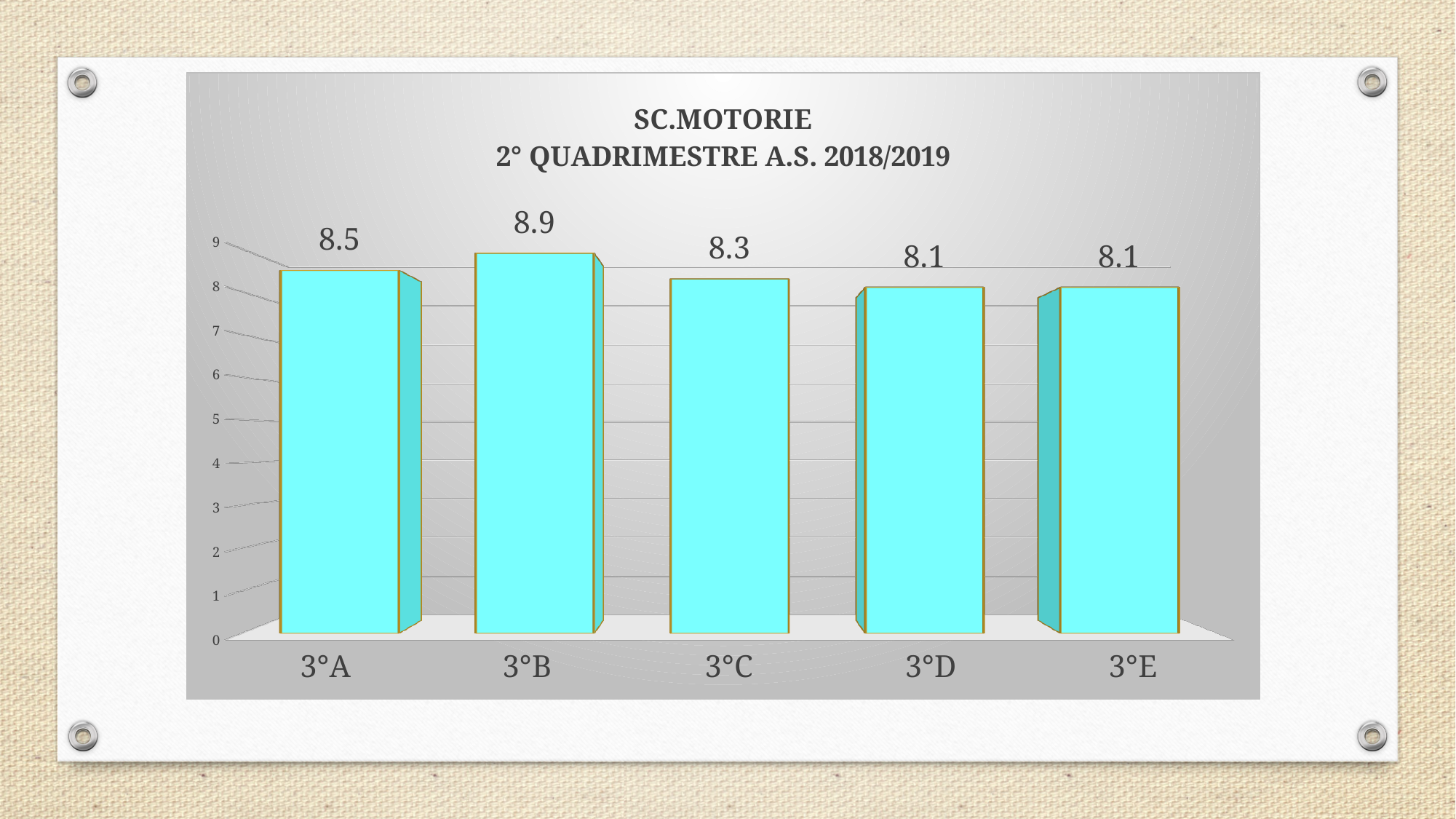
What is the value for 3°C? 8.3 What is the difference between the values for 3°C and 3°D? 0.2 What is the difference between the values for 3°B and 3°A? 0.4 What kind of chart is shown on the slide? bar chart How many classes are shown on the chart? 5 What is the value for 3°D? 8.1 What is the value for 3°B? 8.9 What is the title of the chart? SC.MOTORIE 2° QUADRIMESTRE A.S. 2018/2019 Which class has the highest value? 3°B What is the value for 3°A? 8.5 Is the value for 3°E greater or less than 7? greater Which is larger, the value for 3°A or the value for 3°C? 3°A